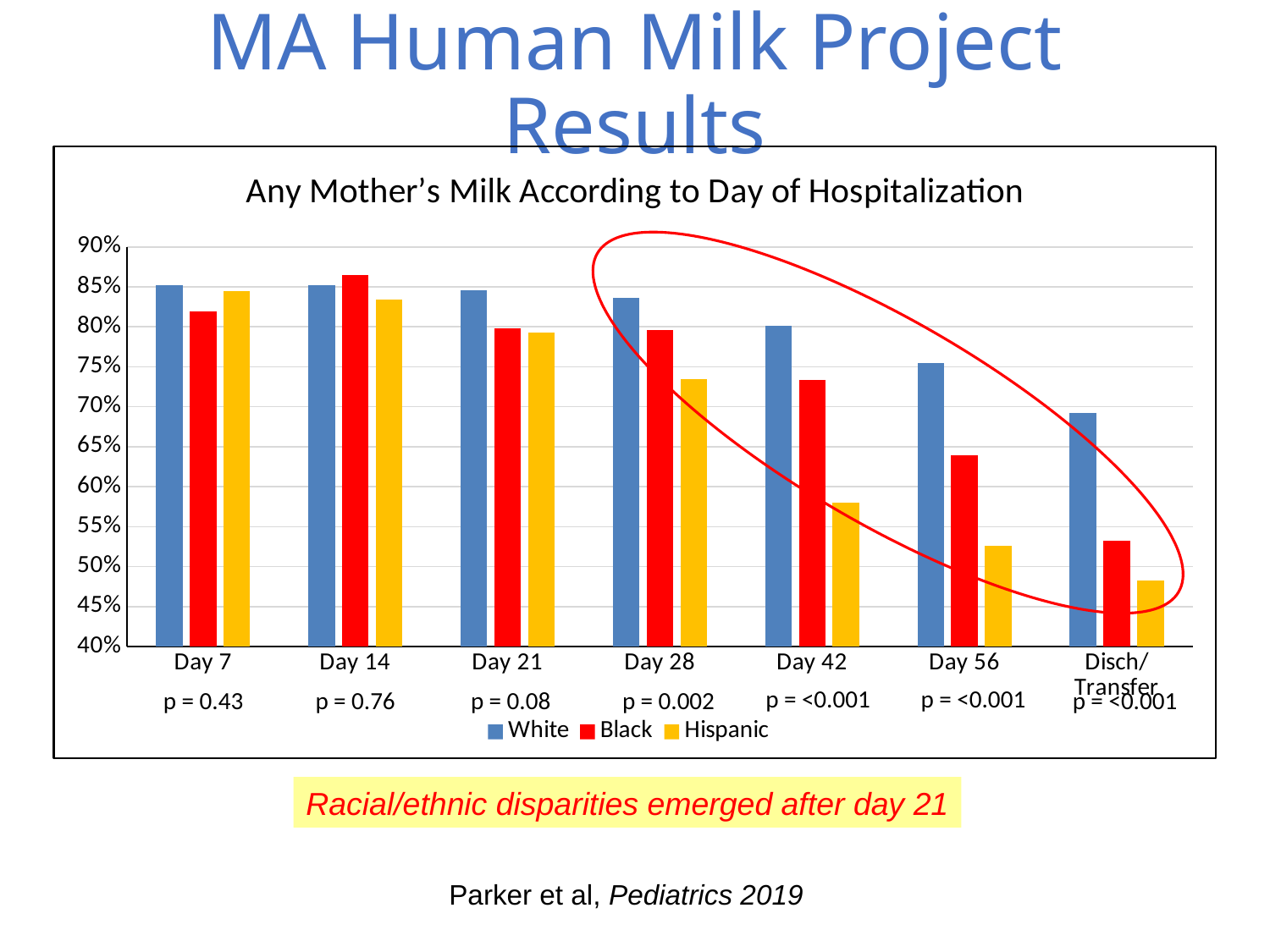
Is the value for Hispanic at Day 42 greater or less than 60%? less At Day 56, which is larger: the value for Black or the value for Hispanic? Black For the Hispanic series, which category has the lowest value? Disch/Transfer What kind of chart is shown on the slide? Bar chart What is the title of the chart? Any Mother's Milk According to Day of Hospitalization At Day 42, which is larger: the value for White or the value for Black? White Is the value for Black at Disch/Transfer greater or less than 55%? less How many categories are shown along the x axis? 7 At Day 14, which series has the highest value? Black Do the values for the White series rise or fall from Day 7 to Disch/Transfer? fall Is the value for White at Day 56 greater or less than 70%? greater How many series does the legend list? 3